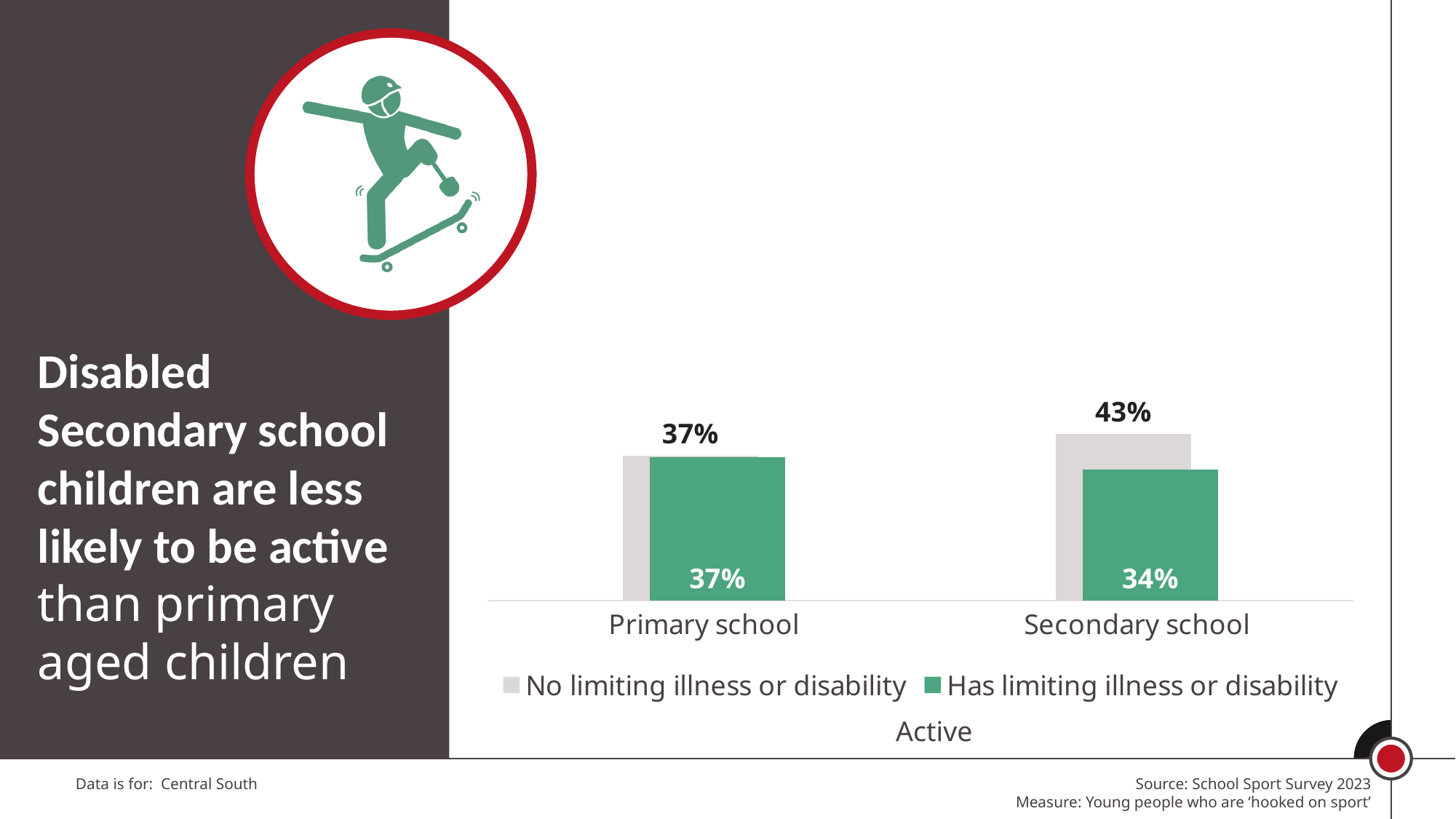
What is the title shown below the legend of the chart? Active What kind of chart is shown? Bar chart Which school stage has the highest value for 'No limiting illness or disability'? Secondary school What is the value for 'Has limiting illness or disability' at Primary school? 37% Which is larger at Secondary school: 'No limiting illness or disability' or 'Has limiting illness or disability'? No limiting illness or disability How many series does the legend list? 2 Which school stage has the lowest value for 'Has limiting illness or disability'? Secondary school What is the difference between the 'No limiting illness or disability' and 'Has limiting illness or disability' values at Secondary school? 9% What is the value for 'No limiting illness or disability' at Primary school? 37% What is the value for 'No limiting illness or disability' at Secondary school? 43% How many categories are shown on the x axis? 2 What is the value for 'Has limiting illness or disability' at Secondary school? 34%